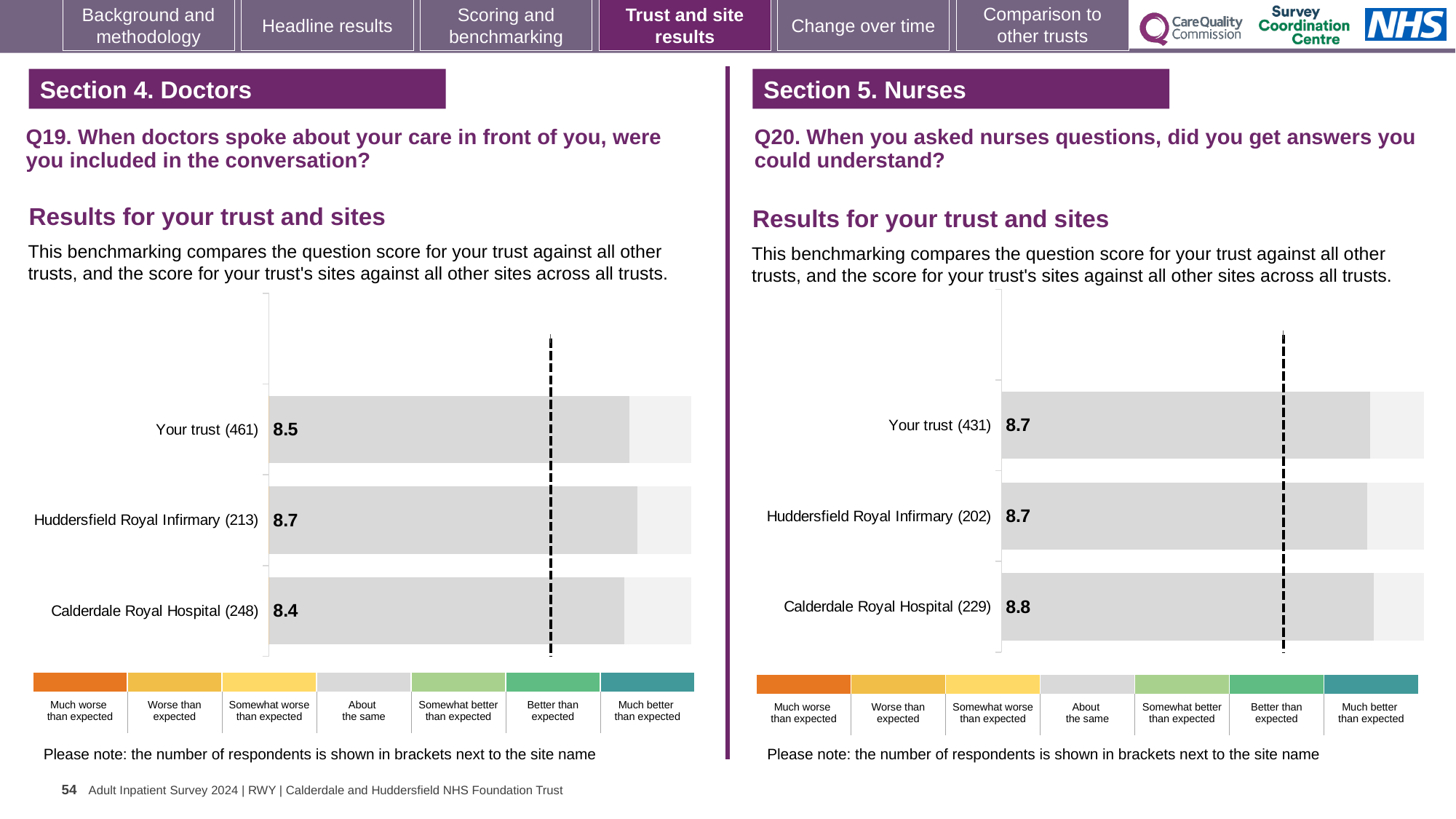
On the Q20 chart (right), what is the score for Calderdale Royal Hospital? 8.8 On the Q20 chart (right), what is the score for Your trust? 8.7 On the Q19 chart (left), what is the score for Your trust? 8.5 On the Q19 chart (left), what is the difference between the Huddersfield Royal Infirmary score and the Calderdale Royal Hospital score? 0.3 On the Q19 chart (left), which site or trust has the highest score? Huddersfield Royal Infirmary On the Q19 chart (left), which site or trust has the lowest score? Calderdale Royal Hospital On the Q20 chart (right), how many bars are plotted? 3 On the Q20 chart (right), how many respondents are shown in brackets for Huddersfield Royal Infirmary? 202 What type of chart is used on the Q19 chart (left)? Bar chart On the Q19 chart (left), what is the score for Huddersfield Royal Infirmary? 8.7 On the Q20 chart (right), which site or trust has the highest score? Calderdale Royal Hospital On the Q19 chart (left), what is the score for Calderdale Royal Hospital? 8.4